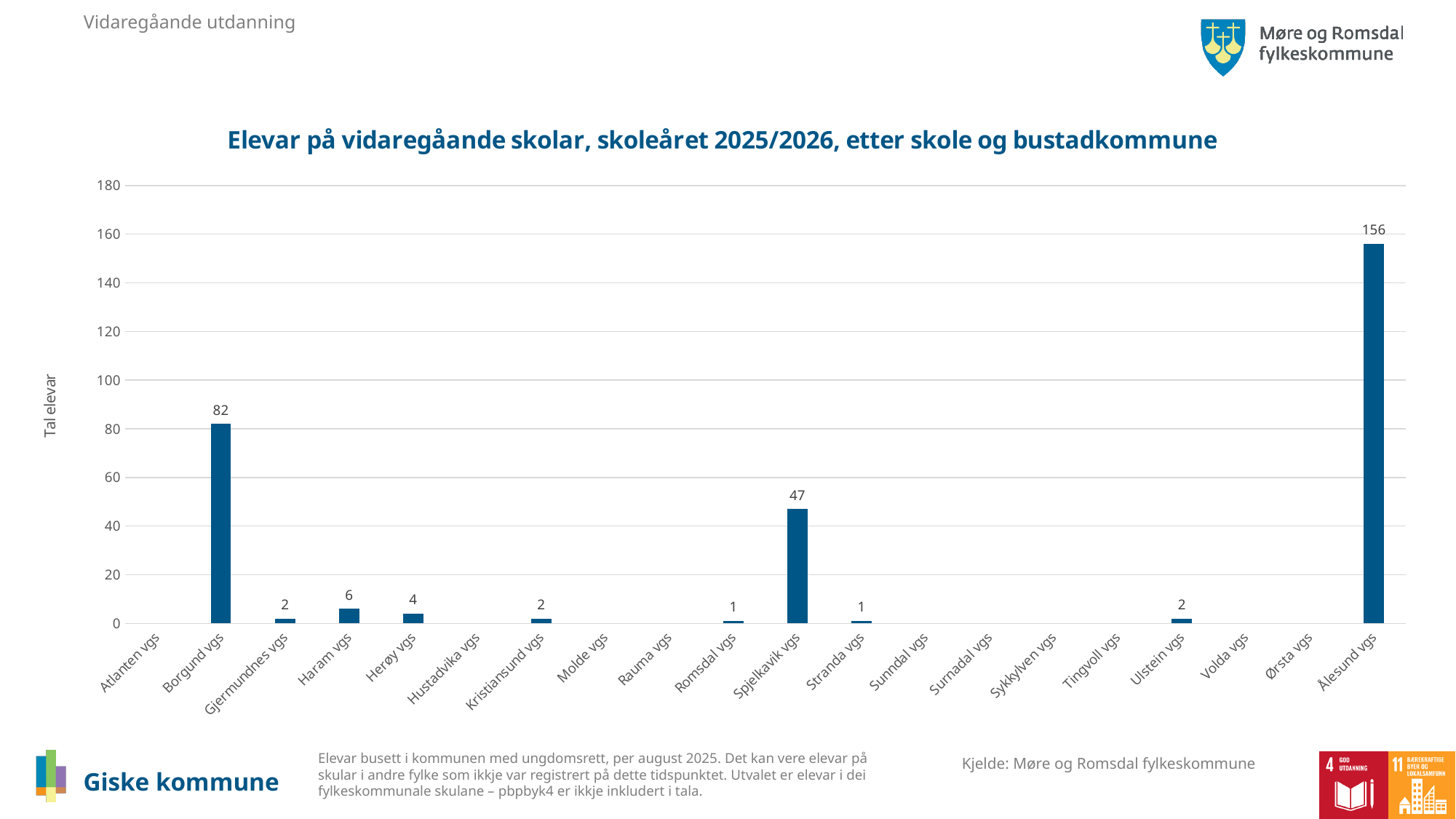
Which is larger, the value for Haram vgs or the value for Herøy vgs? Haram vgs Which school has the highest number of pupils? Ålesund vgs What is the value for Herøy vgs? 4 What is the difference between the values for Borgund vgs and Spjelkavik vgs? 35 What is the value for Borgund vgs? 82 What is the value for Ålesund vgs? 156 What is the difference between the values for Ålesund vgs and Borgund vgs? 74 What is the value for Haram vgs? 6 How many schools are listed on the x axis? 20 What kind of chart is shown on the slide? Bar chart What is the value for Spjelkavik vgs? 47 What is the label of the y axis? Tal elevar